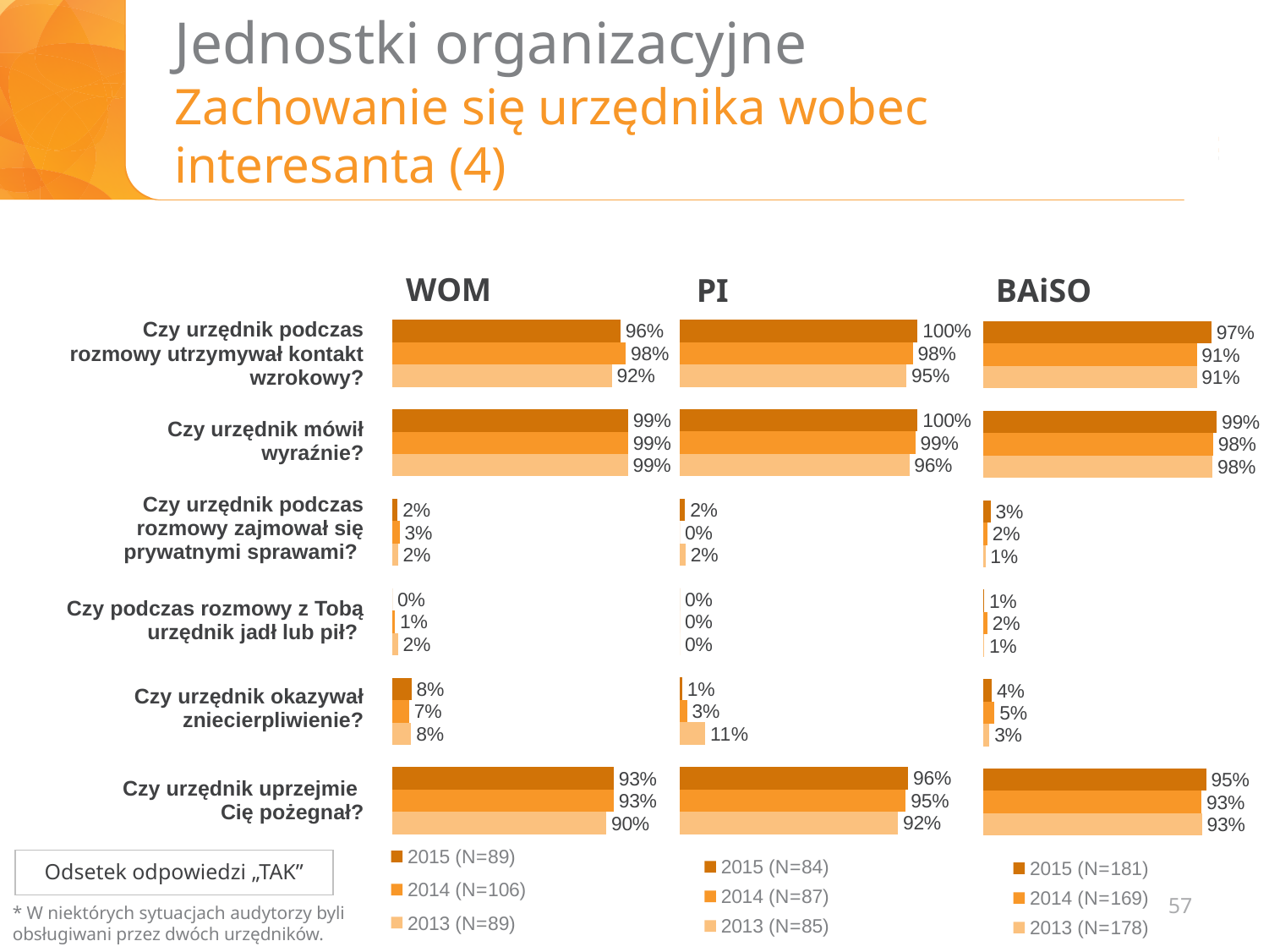
In the WOM chart, which year has the lowest value for "Czy urzędnik podczas rozmowy utrzymywał kontakt wzrokowy?"? 2013 In the WOM chart, which is larger for "Czy urzędnik uprzejmie Cię pożegnał?": the 2015 value or the 2013 value? 2015 How many question categories are shown in the WOM chart? 6 How many series does the legend of the PI chart list? 3 In the WOM chart, what is the 2015 value for "Czy urzędnik podczas rozmowy utrzymywał kontakt wzrokowy?"? 96% In the PI chart, which year has the highest value for "Czy urzędnik mówił wyraźnie?"? 2015 What type of chart is used for the BAiSO data? Bar chart In the PI chart, what is the 2013 value for "Czy urzędnik okazywał zniecierpliwienie?"? 11% In the BAiSO chart, what is the 2014 value for "Czy urzędnik uprzejmie Cię pożegnał?"? 93% In the BAiSO chart, what is the difference between the 2015 and 2014 values for "Czy urzędnik podczas rozmowy utrzymywał kontakt wzrokowy?"? 6% In the PI chart, what is the 2014 value for "Czy urzędnik podczas rozmowy zajmował się prywatnymi sprawami?"? 0% According to the legend of the BAiSO chart, what is the sample size (N) for 2015? 181